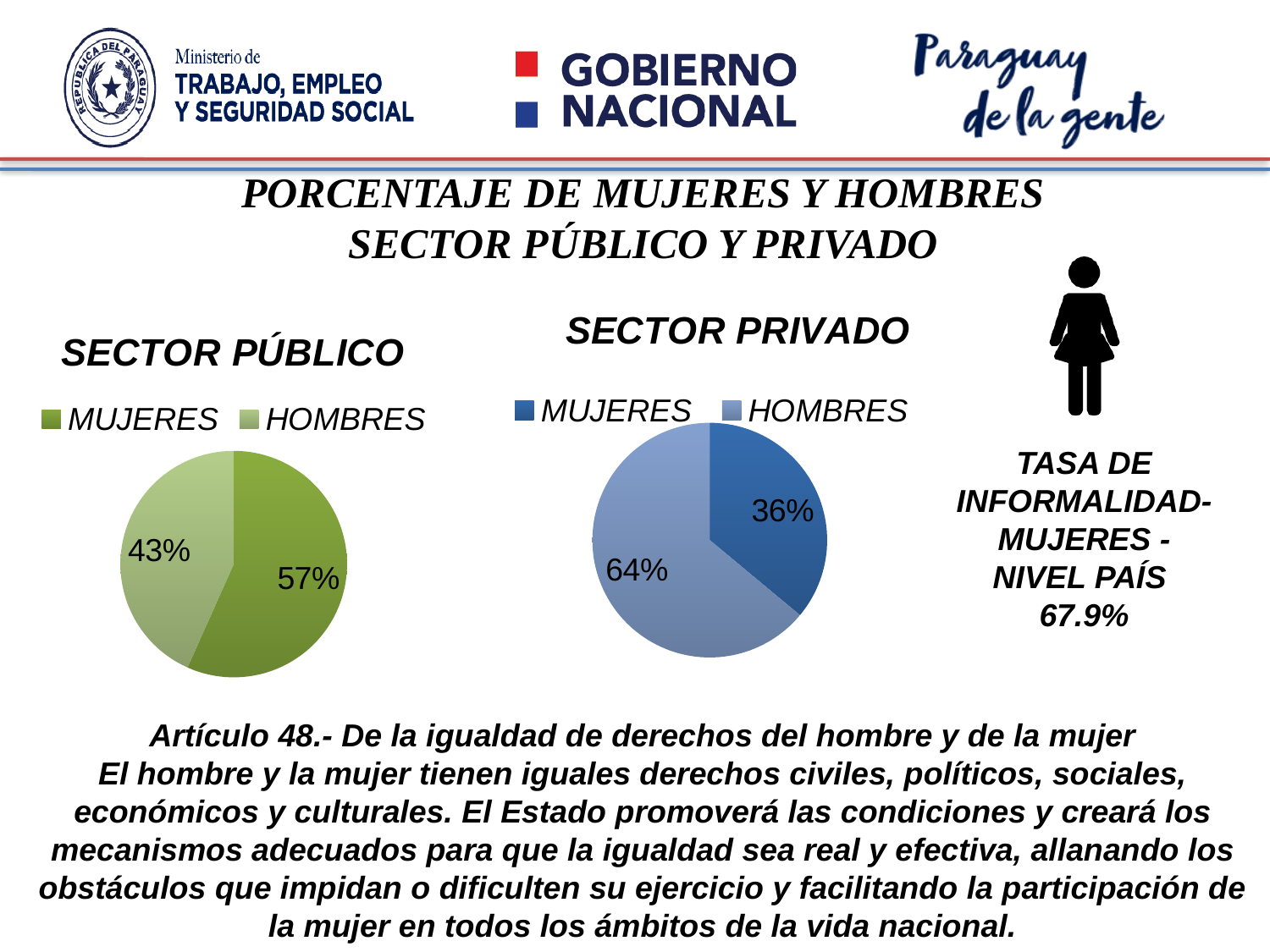
Is the value for MUJERES larger in the SECTOR PÚBLICO chart or in the SECTOR PRIVADO chart? SECTOR PÚBLICO In the SECTOR PÚBLICO chart, which category has the largest slice? MUJERES How many categories does the SECTOR PÚBLICO chart show? 2 In the SECTOR PRIVADO chart, what is the value for MUJERES? 36% In the SECTOR PRIVADO chart, what colour is the MUJERES slice? Dark blue In the SECTOR PRIVADO chart, which category has the smallest slice? MUJERES In the SECTOR PRIVADO chart, what is the value for HOMBRES? 64% In the SECTOR PRIVADO chart, what is the difference between HOMBRES and MUJERES? 28% In the SECTOR PÚBLICO chart, what is the value for MUJERES? 57% In the SECTOR PÚBLICO chart, what is the difference between MUJERES and HOMBRES? 14% In the SECTOR PÚBLICO chart, what is the value for HOMBRES? 43% What type of chart is the SECTOR PRIVADO chart? Pie chart